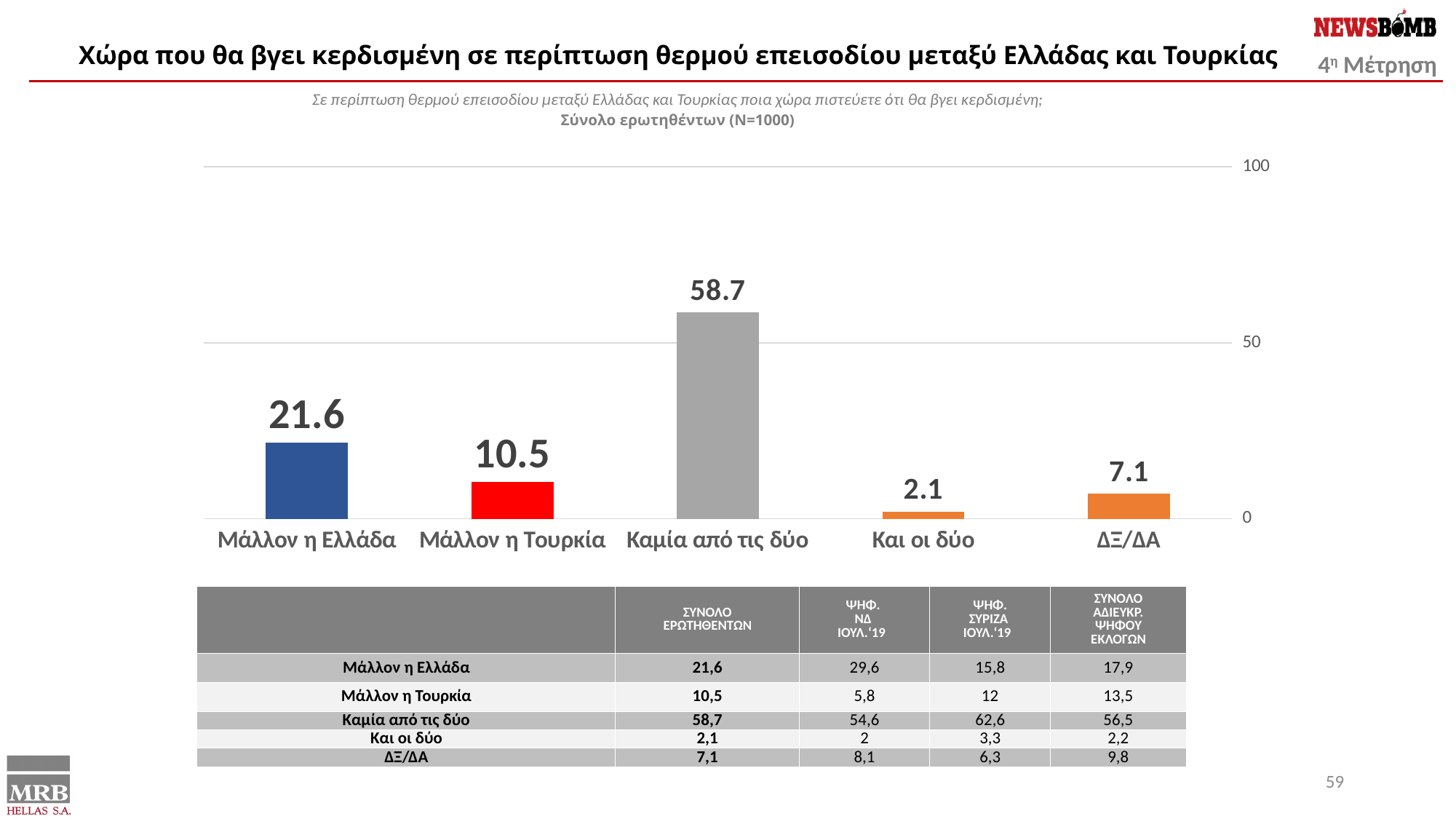
What colour is the bar for "Μάλλον η Τουρκία"? red What is the difference between the values for "Μάλλον η Ελλάδα" and "Μάλλον η Τουρκία"? 11.1 Which category has the highest value? Καμία από τις δύο Is the value for "Καμία από τις δύο" greater or less than 50? greater How many categories are shown in the chart? 5 What kind of chart is shown on the slide? bar chart Which is larger, the value for "ΔΞ/ΔΑ" or the value for "Και οι δύο"? ΔΞ/ΔΑ What is the sample size (N) stated in the chart subtitle? N=1000 Which category has the lowest value? Και οι δύο What is the value for "Μάλλον η Ελλάδα"? 21.6 What is the value for "Καμία από τις δύο"? 58.7 What is the value for "ΔΞ/ΔΑ"? 7.1